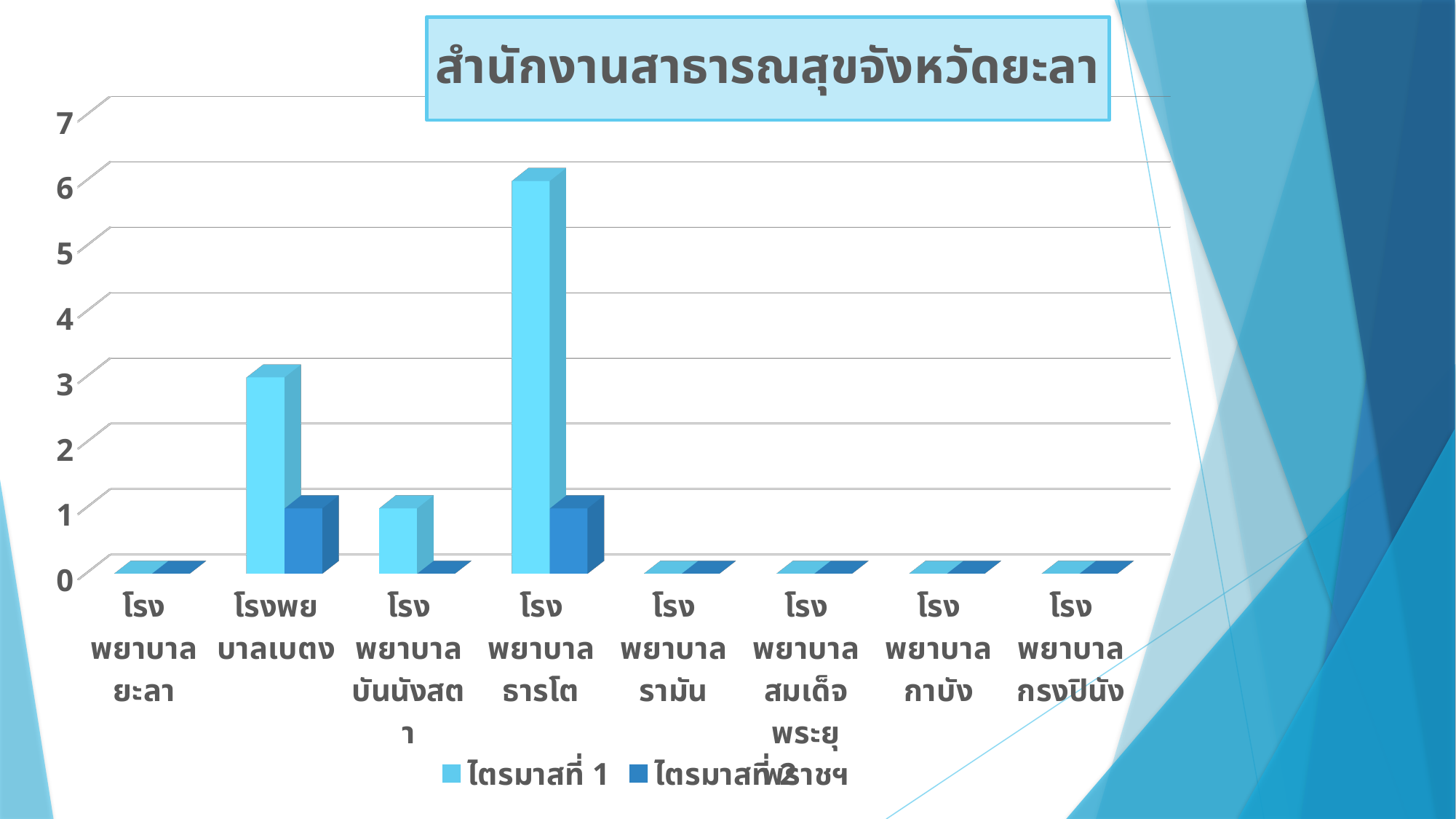
What is the value for ไตรมาสที่ 1 at โรงพยาบาลเบตง? 3 What is the value for ไตรมาสที่ 1 at โรงพยาบาลธารโต? 6 How many series does the legend list? 2 What is the title of the chart? สำนักงานสาธารณสุขจังหวัดยะลา Is the value for ไตรมาสที่ 1 at โรงพยาบาลธารโต greater or less than 5? greater How many hospital categories are shown on the x axis? 8 What is the value for ไตรมาสที่ 1 at โรงพยาบาลบันนังสตา? 1 Which hospital has the highest value for ไตรมาสที่ 1? โรงพยาบาลธารโต What is the difference between the ไตรมาสที่ 1 values for โรงพยาบาลธารโต and โรงพยาบาลเบตง? 3 Which is larger at โรงพยาบาลธารโต: the value for ไตรมาสที่ 1 or ไตรมาสที่ 2? ไตรมาสที่ 1 What is the value for ไตรมาสที่ 2 at โรงพยาบาลเบตง? 1 What kind of chart is shown on the slide? bar chart